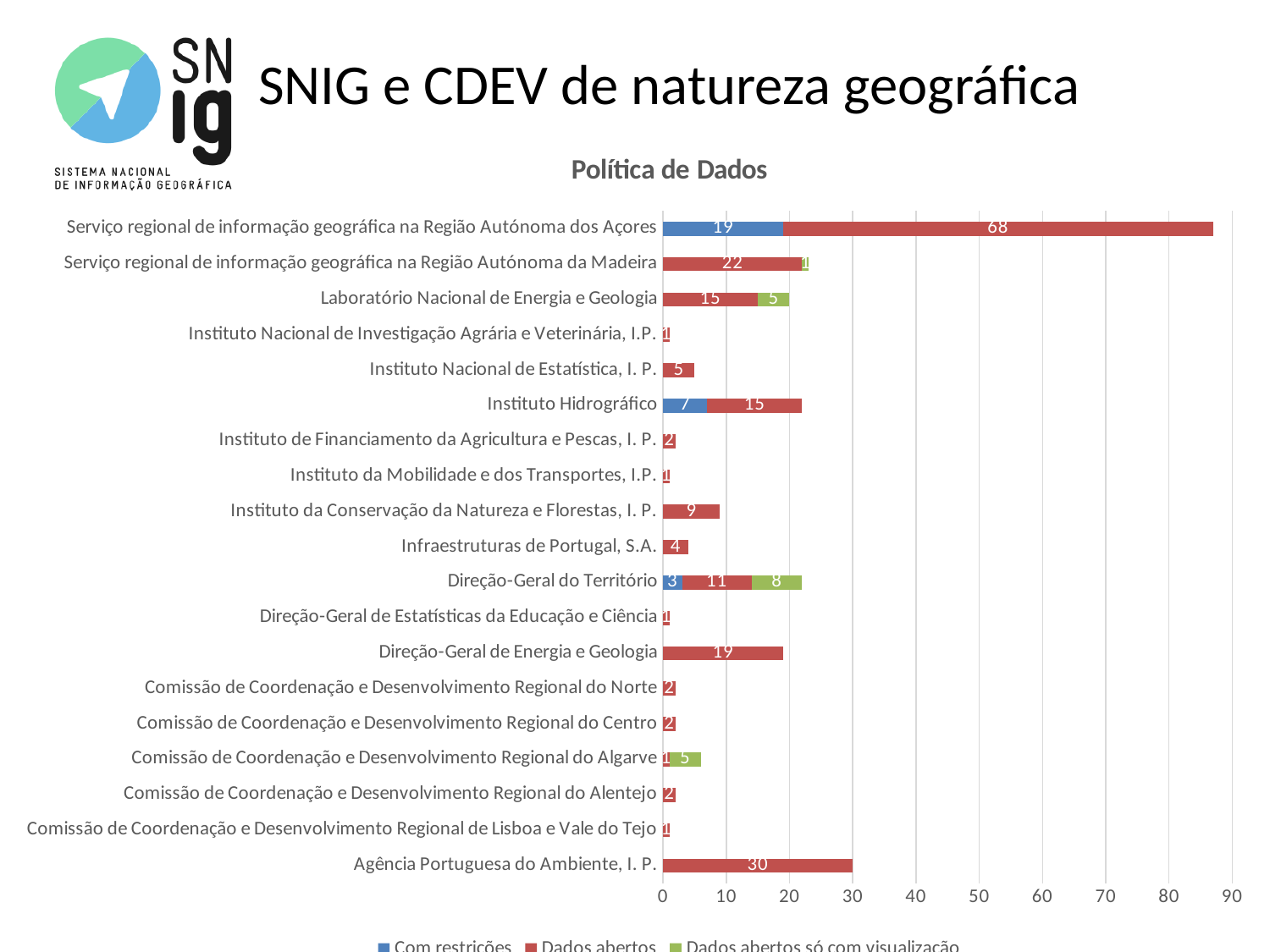
How many organisations (categories) are shown on the chart? 19 What kind of chart is shown on the slide? Stacked bar chart Which has a larger 'Dados abertos' value: Instituto da Conservação da Natureza e Florestas, I. P. or Infraestruturas de Portugal, S.A.? Instituto da Conservação da Natureza e Florestas, I. P. What is the 'Dados abertos só com visualização' value for Direção-Geral do Território? 8 What is the 'Com restrições' value for Instituto Hidrográfico? 7 What is the title of the chart? Política de Dados What is the difference between the 'Dados abertos' values for Agência Portuguesa do Ambiente, I. P. and Direção-Geral de Energia e Geologia? 11 How many series does the legend list? 3 What is the 'Dados abertos' value for Agência Portuguesa do Ambiente, I. P.? 30 What is the 'Dados abertos' value for Serviço regional de informação geográfica na Região Autónoma dos Açores? 68 What is the total of the stacked bar for Direção-Geral do Território? 22 Which organisation has the longest total bar? Serviço regional de informação geográfica na Região Autónoma dos Açores